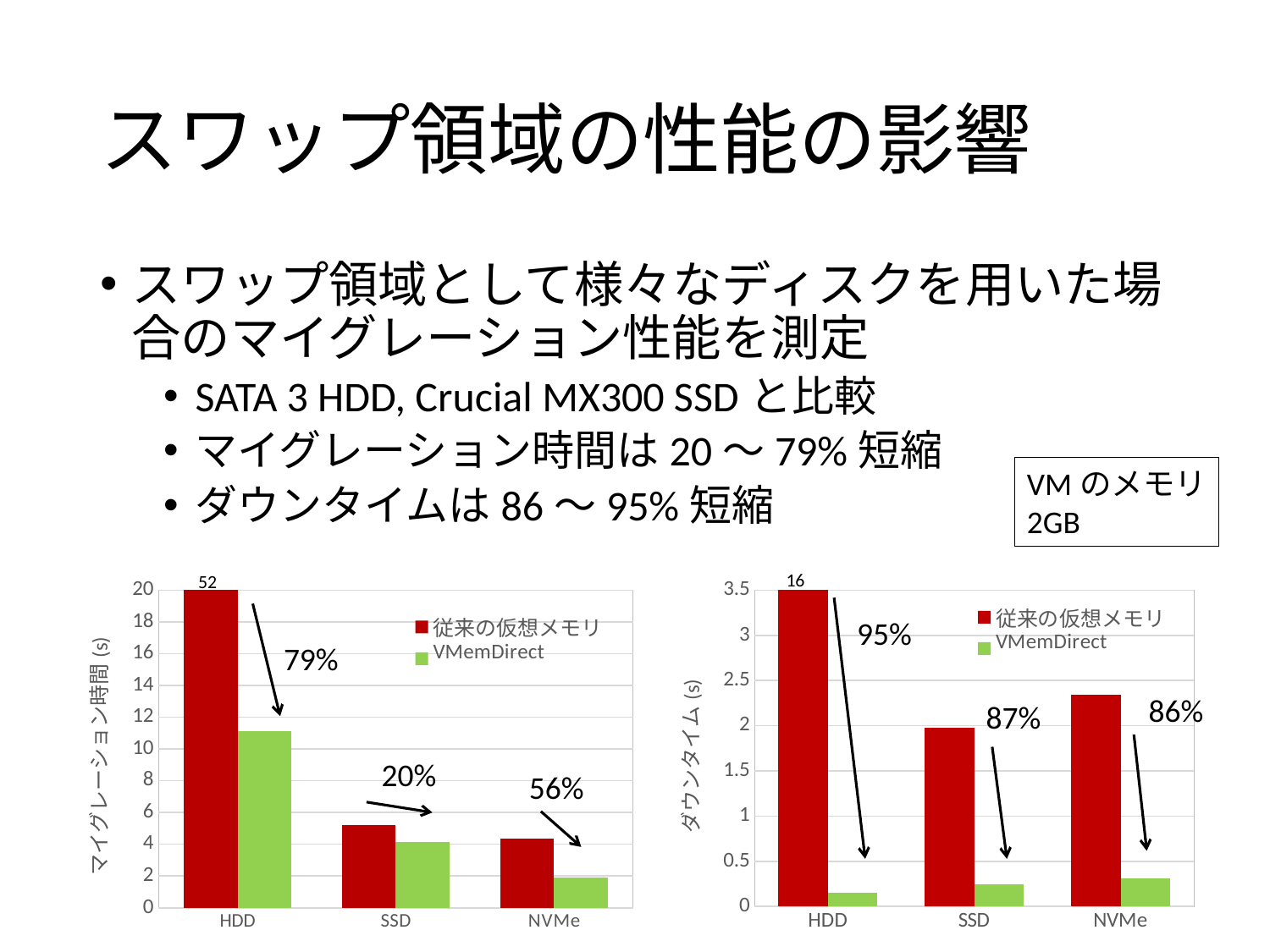
In the left chart (マイグレーション時間), what value is labelled on the 従来の仮想メモリ bar for HDD? 52 In the right chart (ダウンタイム), which is larger for 従来の仮想メモリ: SSD or NVMe? NVMe In the left chart (マイグレーション時間), which category has the highest 従来の仮想メモリ value? HDD In the right chart (ダウンタイム), which category has the lowest VMemDirect value? HDD In the left chart (マイグレーション時間), is the VMemDirect value for HDD greater or less than 10? greater In the right chart (ダウンタイム), what value is labelled on the 従来の仮想メモリ bar for HDD? 16 In the right chart (ダウンタイム), is the VMemDirect value for NVMe greater or less than 0.5? less In the left chart (マイグレーション時間), is the 従来の仮想メモリ value for SSD greater or less than 4? greater How many categories are shown on the x axis of the left chart (マイグレーション時間)? 3 How many series does the legend of the right chart (ダウンタイム) list? 2 In the left chart (マイグレーション時間), what percentage reduction is annotated for HDD? 79% What kind of chart is the left chart (マイグレーション時間)? bar chart